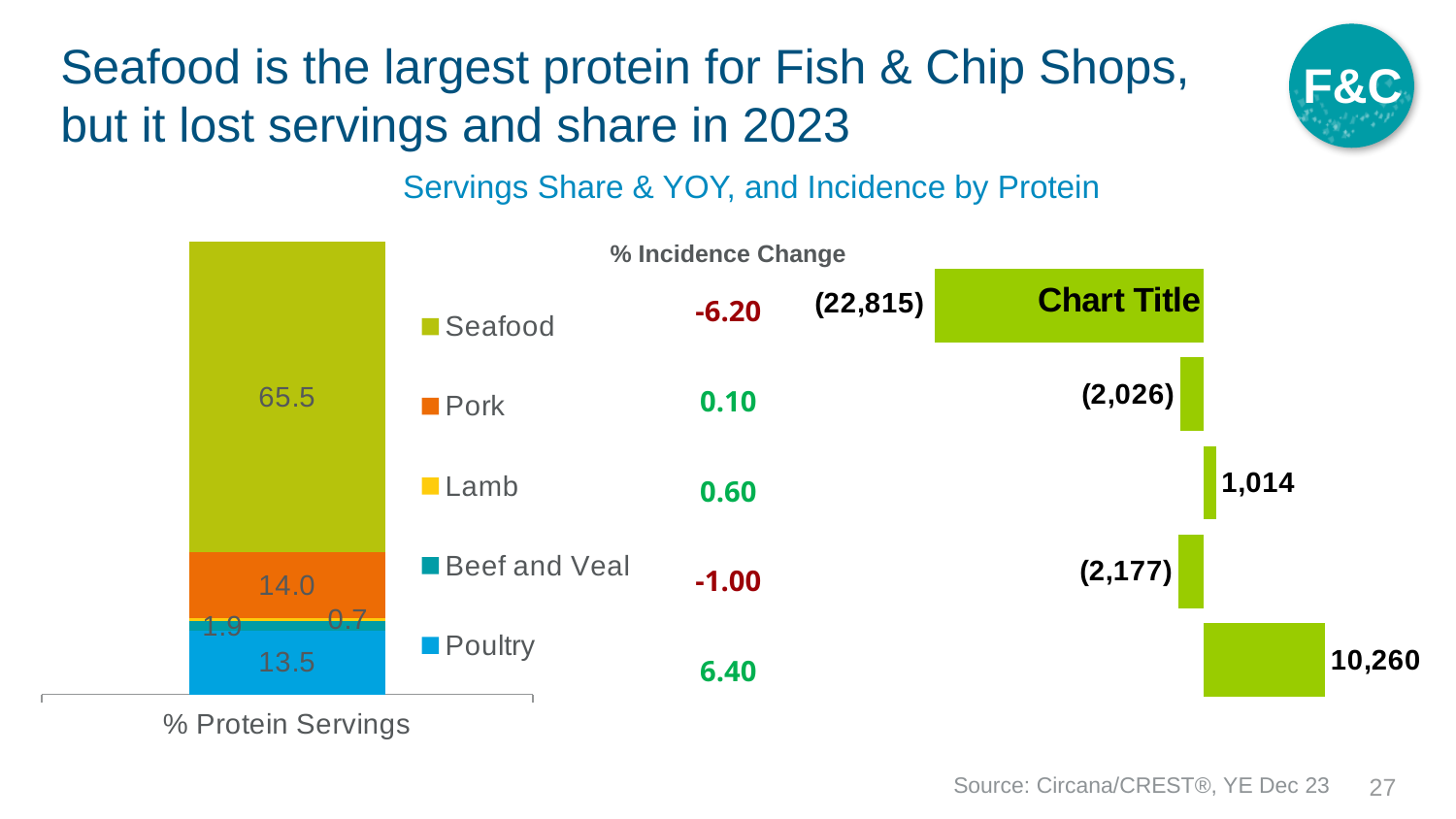
In the stacked bar chart labelled % Protein Servings, what is the value for Pork? 14.0 In the stacked bar chart labelled % Protein Servings, which protein has the smallest share? Lamb In the stacked bar chart labelled % Protein Servings, what is the value for Seafood? 65.5 In the bar chart on the right titled Chart Title, what is the value for Seafood? (22,815) In the bar chart on the right titled Chart Title, what is the value for Poultry? 10,260 In the % Incidence Change column, what is the value for Seafood? -6.20 What kind of chart is the % Protein Servings chart? Stacked bar chart In the stacked bar chart labelled % Protein Servings, what is the difference between the Seafood and Pork values? 51.5 In the stacked bar chart labelled % Protein Servings, which protein has the largest share? Seafood In the stacked bar chart labelled % Protein Servings, what is the value for Poultry? 13.5 In the stacked bar chart labelled % Protein Servings, which is larger, Pork or Poultry? Pork How many entries does the legend of the % Protein Servings chart list? 5